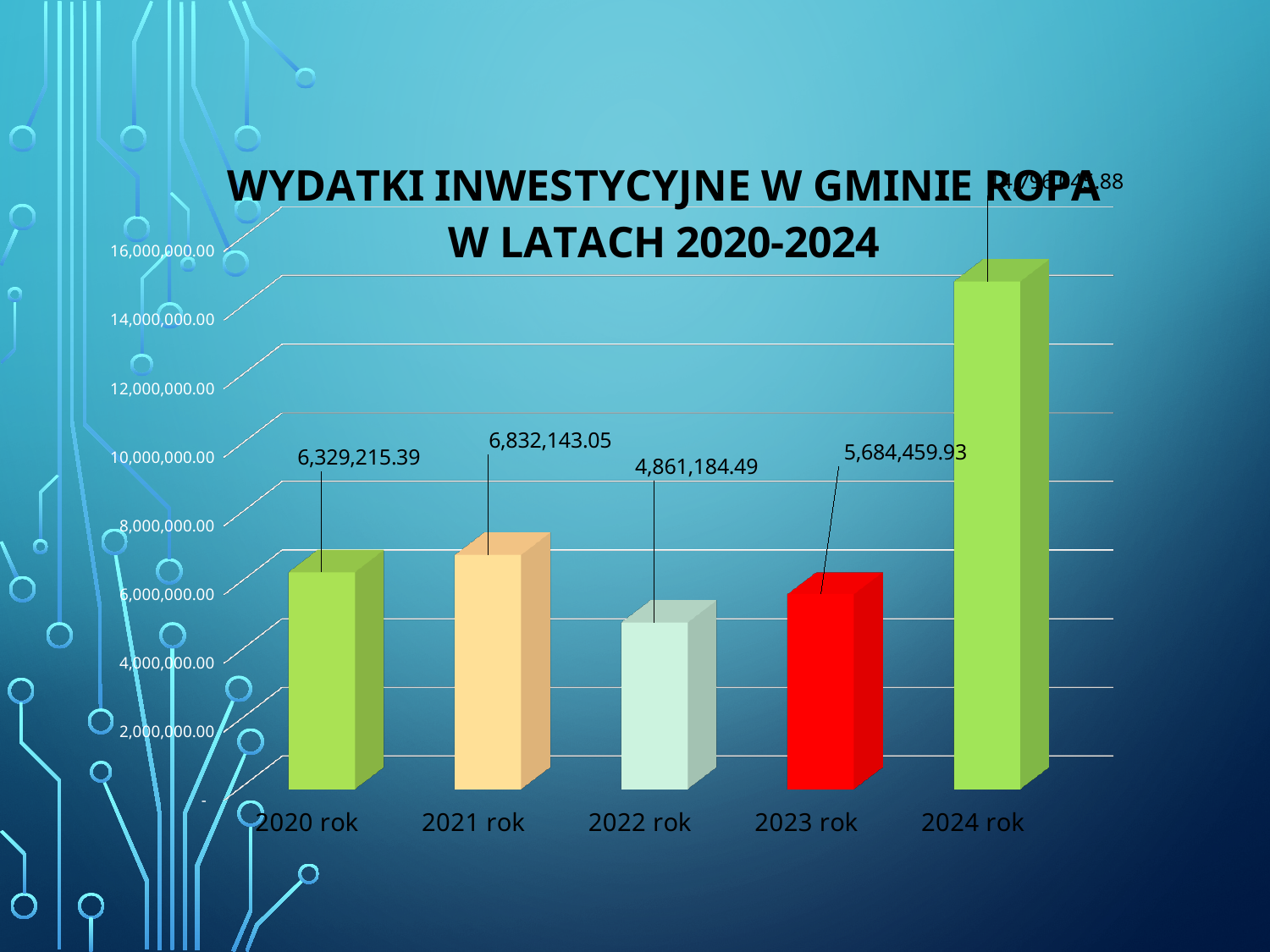
How many years are shown on the chart? 5 What is the value for 2022 rok? 4,861,184.49 What kind of chart is shown on the slide? bar chart What is the difference between the values for 2023 rok and 2022 rok? 823,275.44 Is the value for 2024 rok greater or less than 14,000,000.00? greater What is the value for 2023 rok? 5,684,459.93 What is the difference between the values for 2021 rok and 2020 rok? 502,927.66 Which is larger, the value for 2020 rok or the value for 2023 rok? 2020 rok Which year has the highest value? 2024 rok What is the value for 2021 rok? 6,832,143.05 Which year has the lowest value? 2022 rok What is the value for 2020 rok? 6,329,215.39